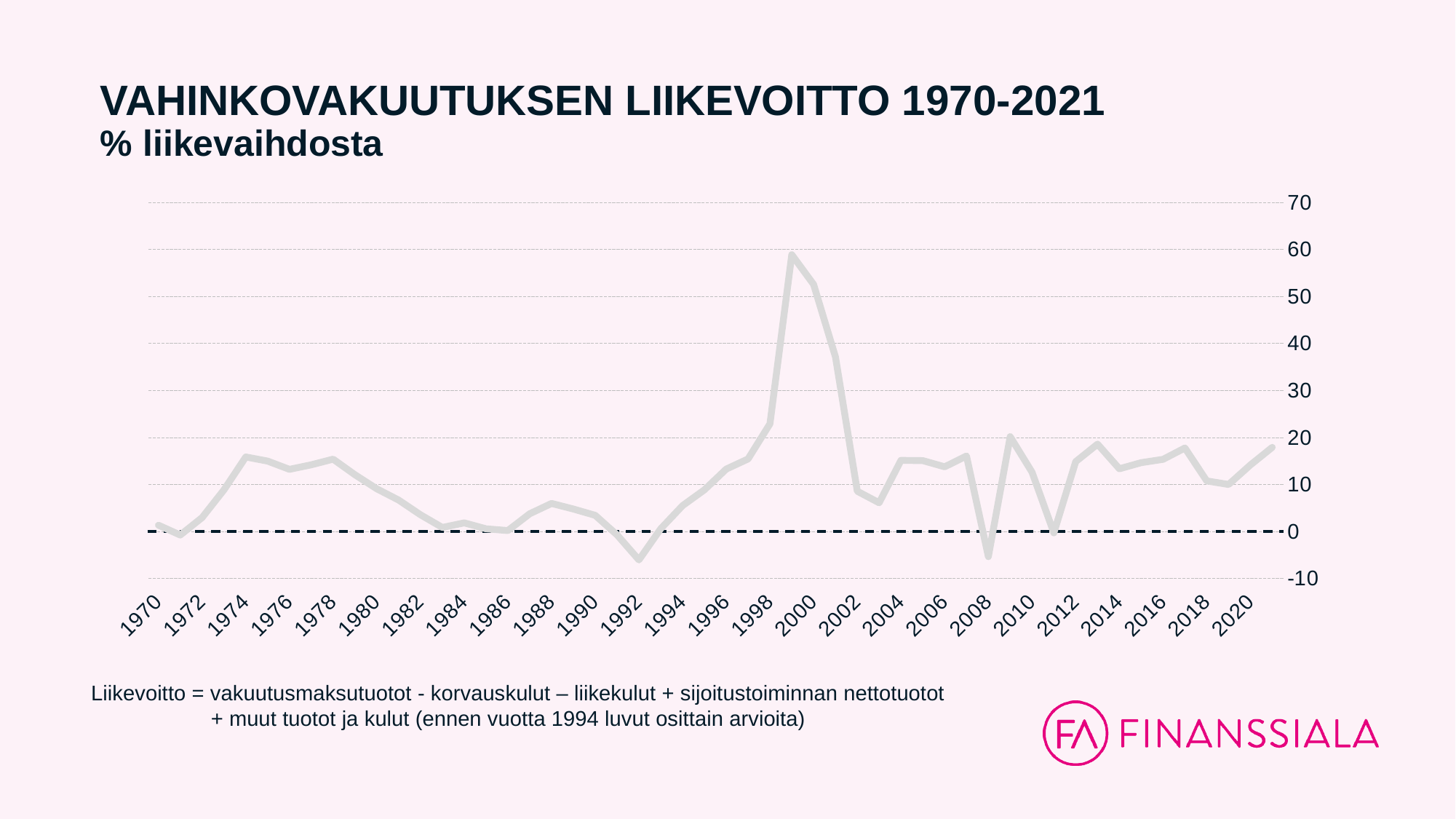
What kind of chart is shown on the slide? line chart What is the title of the chart? VAHINKOVAKUUTUKSEN LIIKEVOITTO 1970-2021 Is the value for 2008 greater or less than 0? less Is the value for 1992 greater or less than 0? less Is the value for 1974 greater or less than 10? greater Which year has the larger value, 2009 or 2011? 2009 Do the values rise or fall between 1999 and 2002? fall In which year does the line reach its highest value? 1999 Which year has the larger value, 1999 or 2000? 1999 How many year labels are shown on the x axis? 26